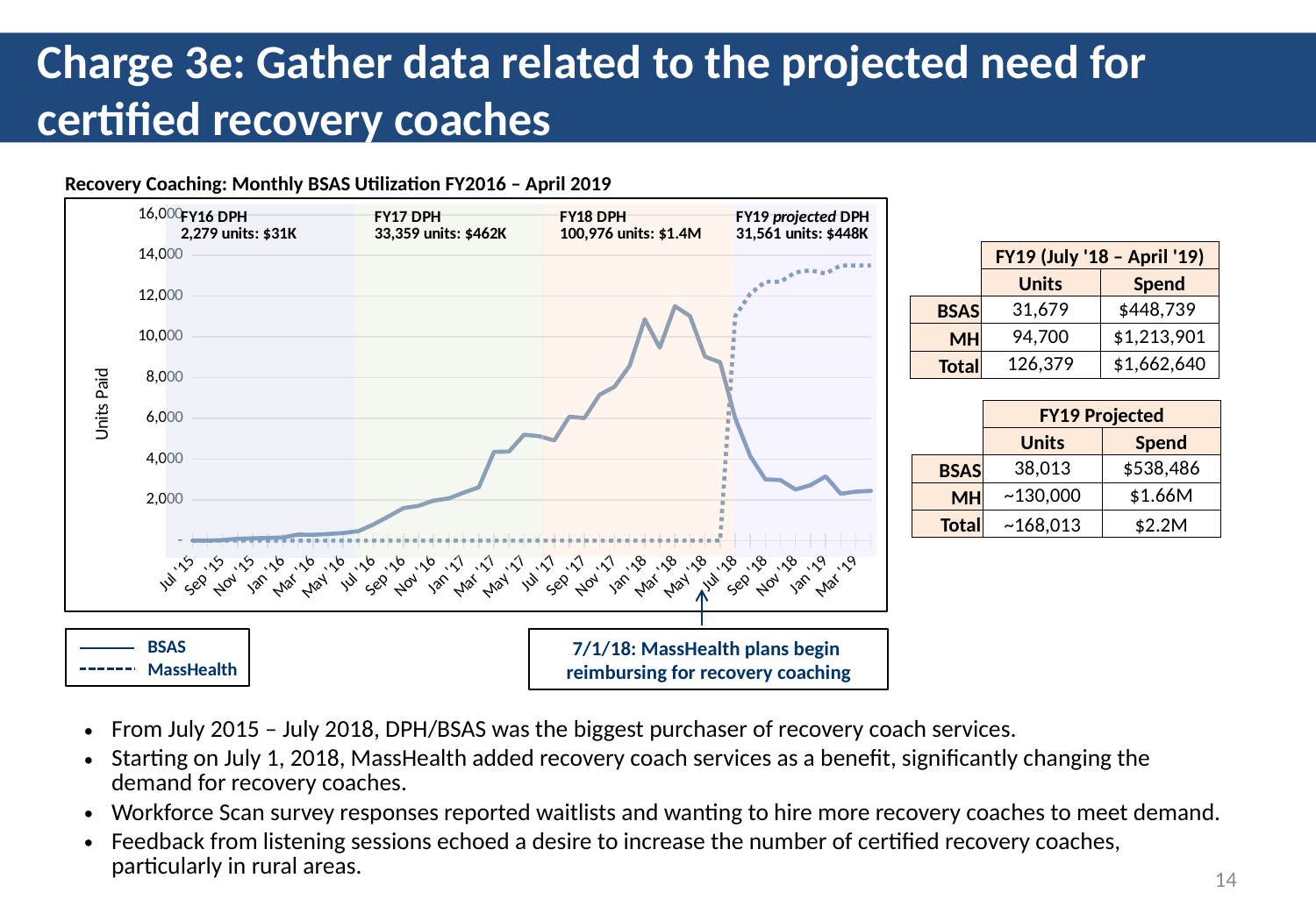
Does the MassHealth line rise or fall from Jul '18 to Mar '19? rise Is the BSAS value at Jul '16 greater or less than 2,000? less At Mar '19, which series has the larger value, BSAS or MassHealth? MassHealth What kind of chart is shown on the slide? line chart According to the chart annotation, how many units are projected for DPH in FY19? 31,561 units Is the BSAS value at its peak in early 2018 greater or less than 10,000? greater According to the chart annotation, how many units did DPH pay for in FY17? 33,359 units How many series does the chart legend list? 2 What are the two series named in the chart legend? BSAS and MassHealth Is the MassHealth value at Mar '19 greater or less than 12,000? greater According to the chart annotation, what was the FY18 DPH spend? $1.4M What is the label on the vertical axis of the chart? Units Paid